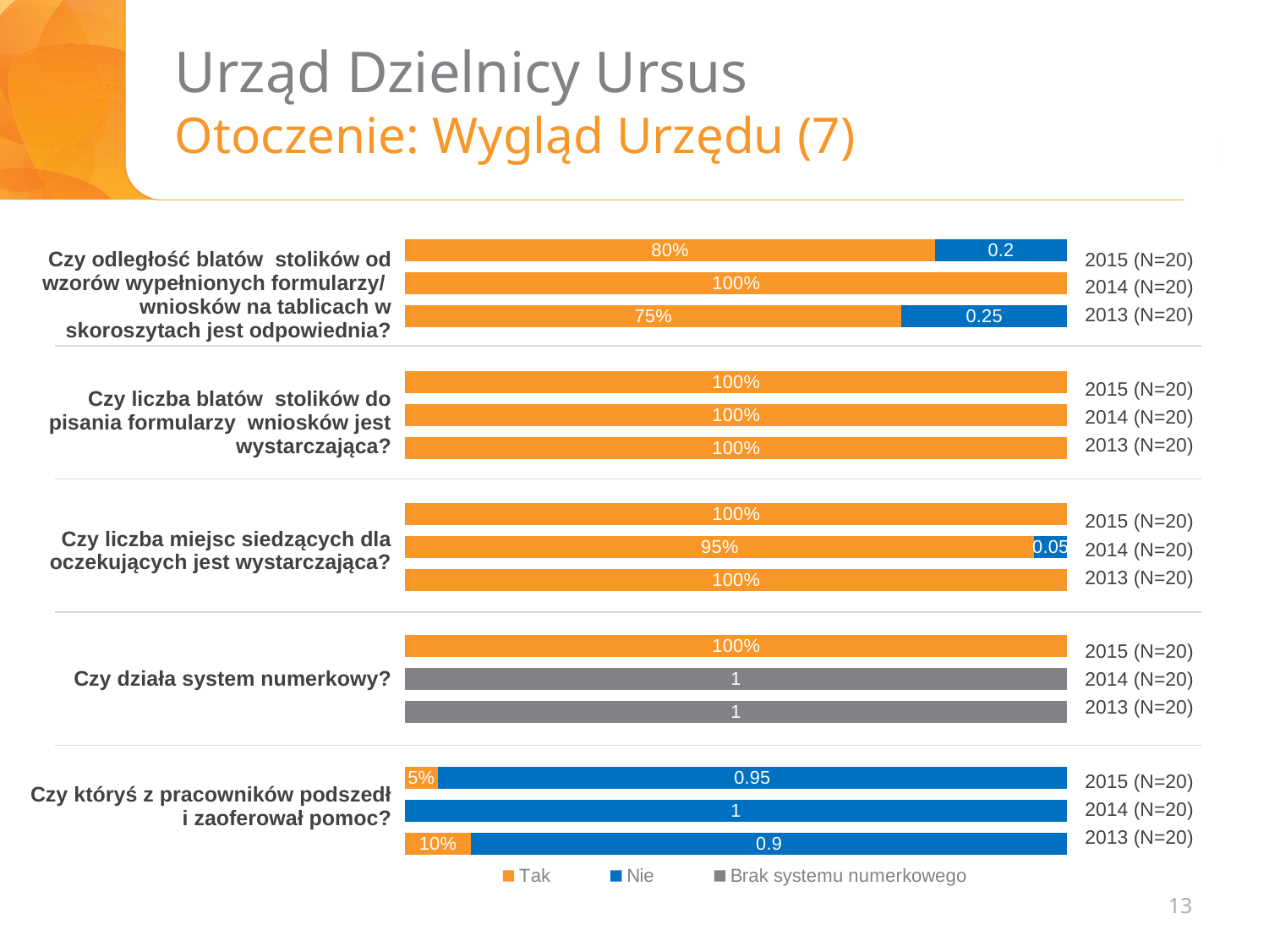
How many series does the legend at the bottom of the slide list? 3 What type of chart is used on this slide? Stacked bar chart In the chart for "Czy któryś z pracowników podszedł i zaoferował pomoc?", what is the Tak value for 2013 (N=20)? 10% In the chart for "Czy odległość blatów stolików od wzorów wypełnionych formularzy/ wniosków na tablicach w skoroszytach jest odpowiednia?", which year has the highest Tak value? 2014 (N=20) In the chart for "Czy odległość blatów stolików od wzorów wypełnionych formularzy/ wniosków na tablicach w skoroszytach jest odpowiednia?", what is the Tak value for 2015 (N=20)? 80% In the chart for "Czy liczba miejsc siedzących dla oczekujących jest wystarczająca?", what is the Tak value for 2014 (N=20)? 95% In the chart for "Czy odległość blatów stolików od wzorów wypełnionych formularzy/ wniosków na tablicach w skoroszytach jest odpowiednia?", what is the Nie value for 2013 (N=20)? 0.25 In the chart for "Czy któryś z pracowników podszedł i zaoferował pomoc?", is the Tak value larger for 2013 (N=20) or 2015 (N=20)? 2013 (N=20) In the chart for "Czy liczba miejsc siedzących dla oczekujących jest wystarczająca?", which year has the lowest Tak value? 2014 (N=20) In the chart for "Czy działa system numerkowy?", what is the Brak systemu numerkowego value for 2013 (N=20)? 1 In the chart for "Czy któryś z pracowników podszedł i zaoferował pomoc?", what is the Nie value for 2015 (N=20)? 0.95 In the chart for "Czy działa system numerkowy?", what is the Tak value for 2015 (N=20)? 100%